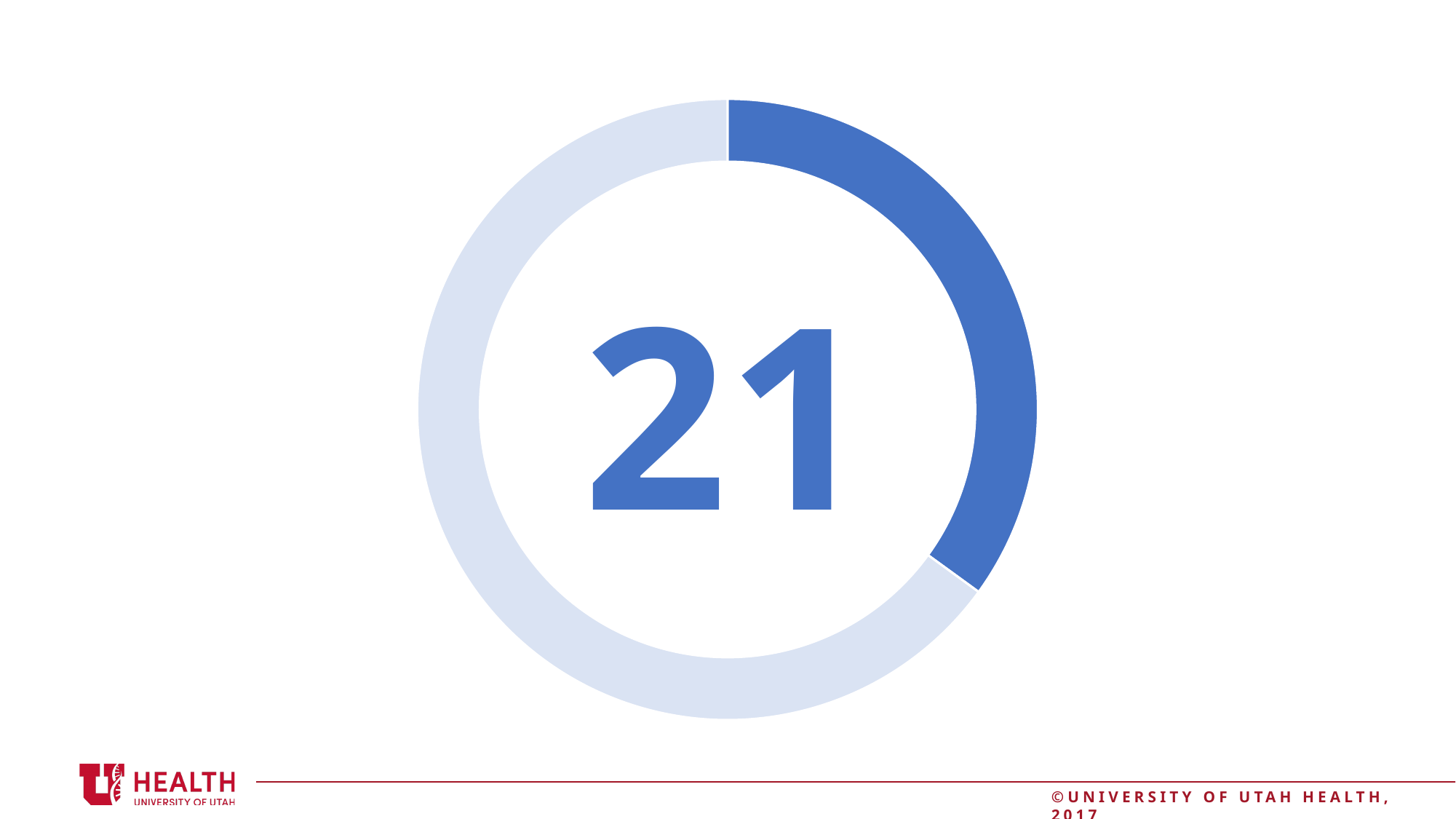
What number is displayed in the center of the donut chart? 21 Does the light blue segment cover more or less than half of the donut ring? More What two colours are used for the segments of the donut chart? Dark blue and light blue Does the donut chart have a legend? No How many segments does the donut chart have? 2 Which segment of the donut chart is larger, the dark blue one or the light blue one? Light blue What kind of chart is shown on the slide? Donut chart Does the dark blue segment cover more or less than half of the donut ring? Less